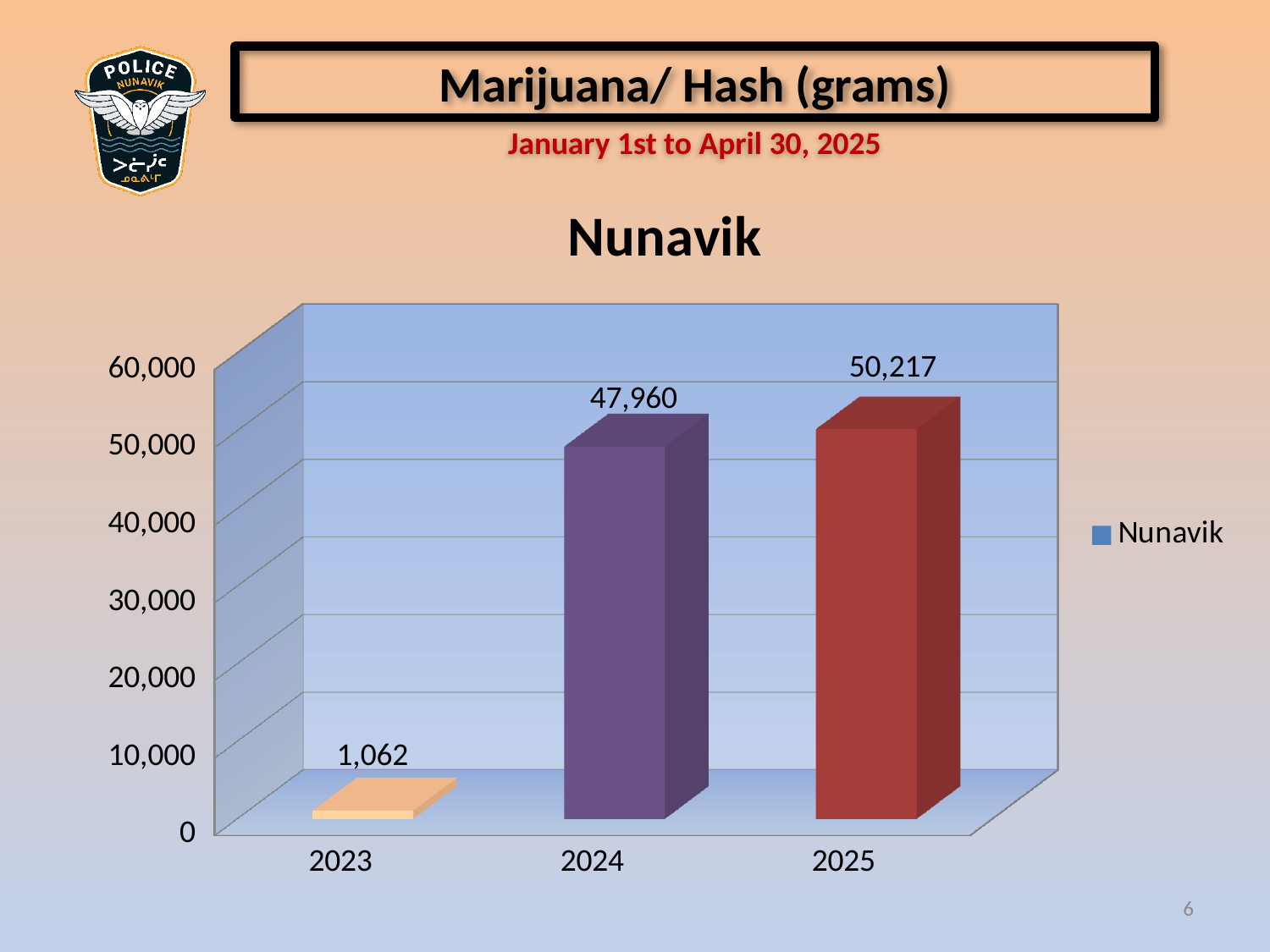
What kind of chart is shown? bar chart What is the value for 2024? 47,960 How many years are shown on the x axis? 3 What is the title of the chart? Nunavik Which year has the lowest value? 2023 What is the difference between the values for 2024 and 2023? 46,898 What is the difference between the values for 2025 and 2024? 2,257 What is the value for 2025? 50,217 Which year has the highest value? 2025 What is the value for 2023? 1,062 Is the value for 2025 greater or less than 40,000? greater Which is larger, the value for 2024 or the value for 2023? 2024